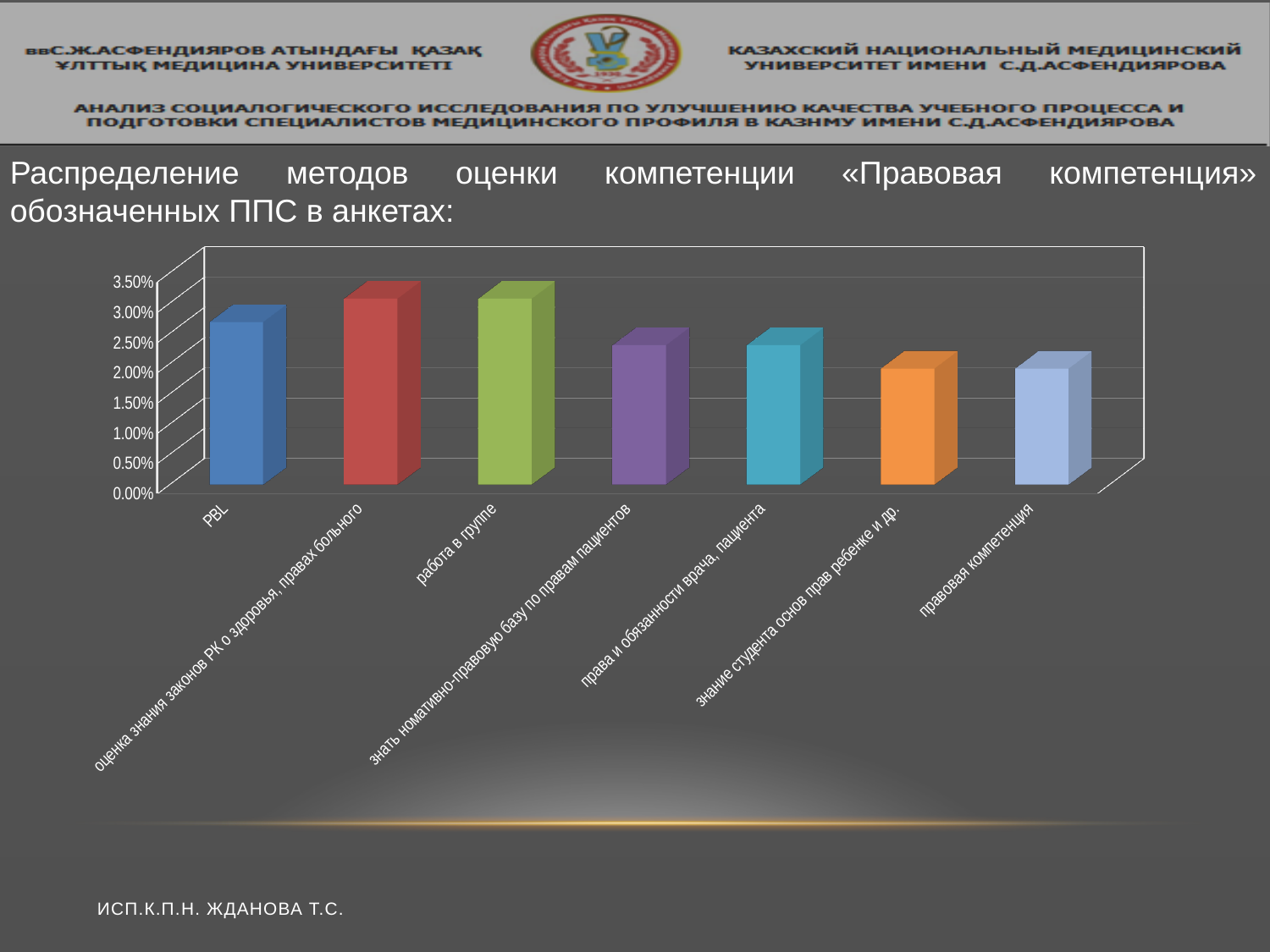
What is the highest value shown on the vertical axis of the chart? 3.50% Is the value for права и обязанности врача, пациента greater or less than 3.00%? less What is the label of the first category on the left of the chart? PBL What kind of chart is shown on the slide? bar chart Which is larger, the value for работа в группе or the value for знание студента основ прав ребенке и др.? работа в группе Is the value for оценка знания законов РК о здоровья, правах больного greater or less than 2.50%? greater Is the value for PBL greater or less than 2.50%? greater How many categories are plotted in the chart? 7 Which is larger, the value for PBL or the value for правовая компетенция? PBL